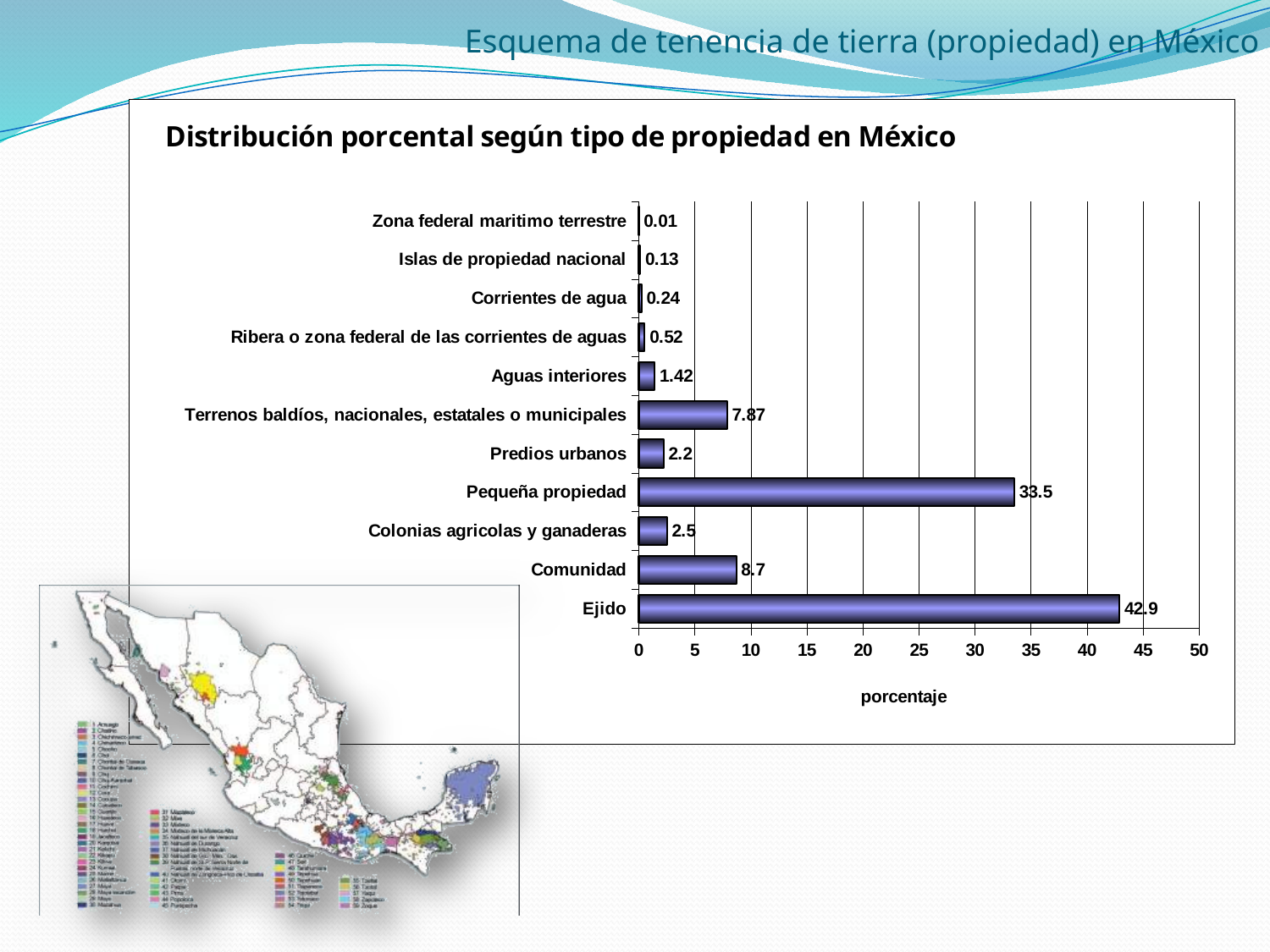
How many categories are shown in the chart? 11 What is the value for Ejido? 42.9 Which is larger, the value for Comunidad or the value for Terrenos baldíos, nacionales, estatales o municipales? Comunidad What is the difference between the values for Ejido and Pequeña propiedad? 9.4 Which category has the highest value? Ejido What is the value for Comunidad? 8.7 What kind of chart is shown on the slide? Bar chart What is the label of the horizontal axis? porcentaje What is the value for Pequeña propiedad? 33.5 Which category has the lowest value? Zona federal maritimo terrestre What is the value for Zona federal maritimo terrestre? 0.01 What is the value for Terrenos baldíos, nacionales, estatales o municipales? 7.87